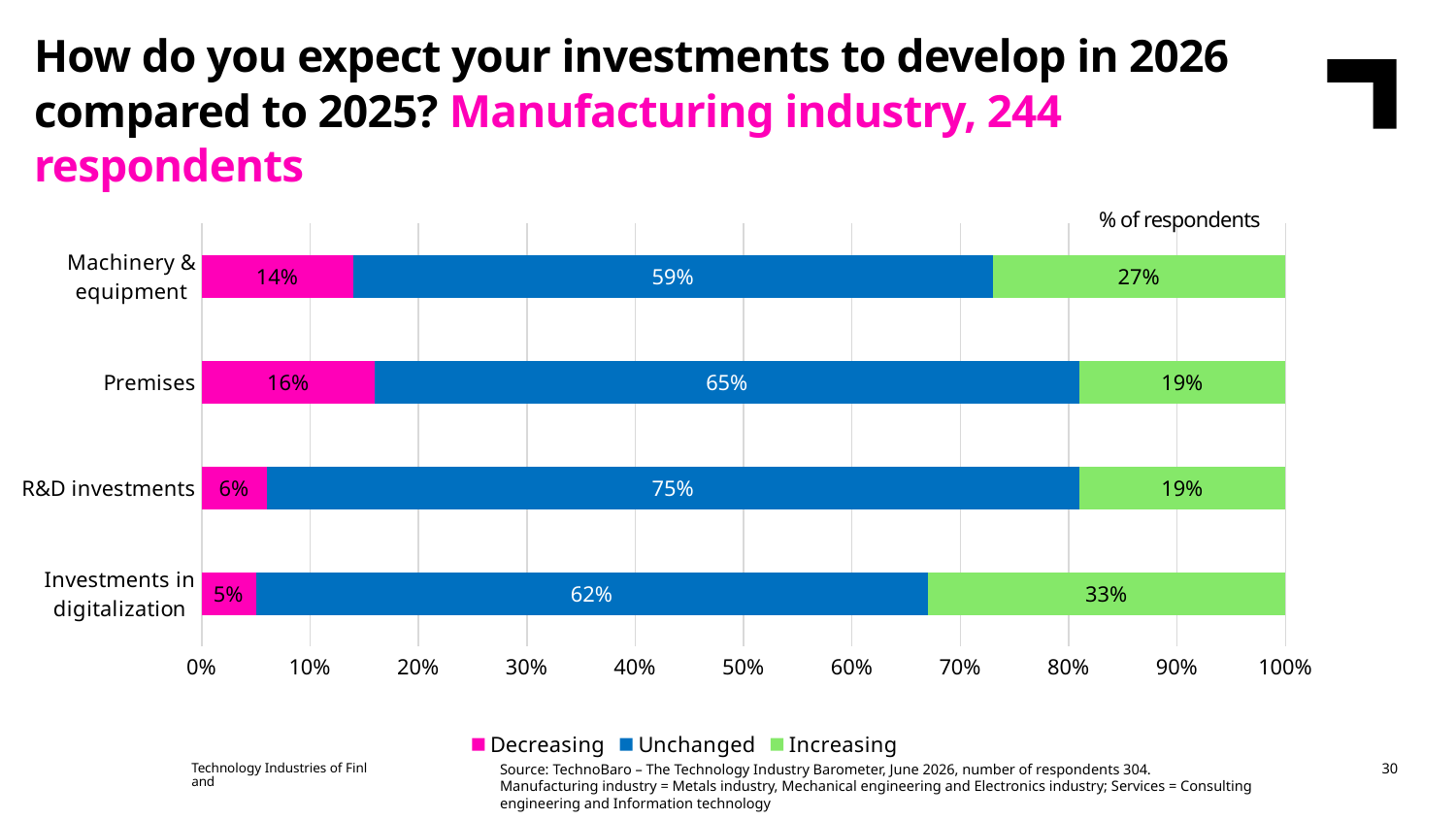
Which category has the lowest share of respondents expecting a decrease? Investments in digitalization What kind of chart is shown on the slide? Stacked bar chart How many investment categories are shown in the chart? 4 Which category has the highest share of respondents expecting an increase? Investments in digitalization Is the 'Unchanged' share larger for R&D investments or for Machinery & equipment? R&D investments What percentage of respondents expect R&D investments to be unchanged? 75% What percentage of respondents expect investments in digitalization to be increasing? 33% Which colour represents the 'Decreasing' series in the chart? Pink (magenta) How many series does the legend list? 3 What is the total of the three segments for the Premises bar? 100% What percentage of respondents expect investments in premises to be decreasing? 16% What is the difference between the 'Increasing' share for Machinery & equipment and for Premises? 8 percentage points